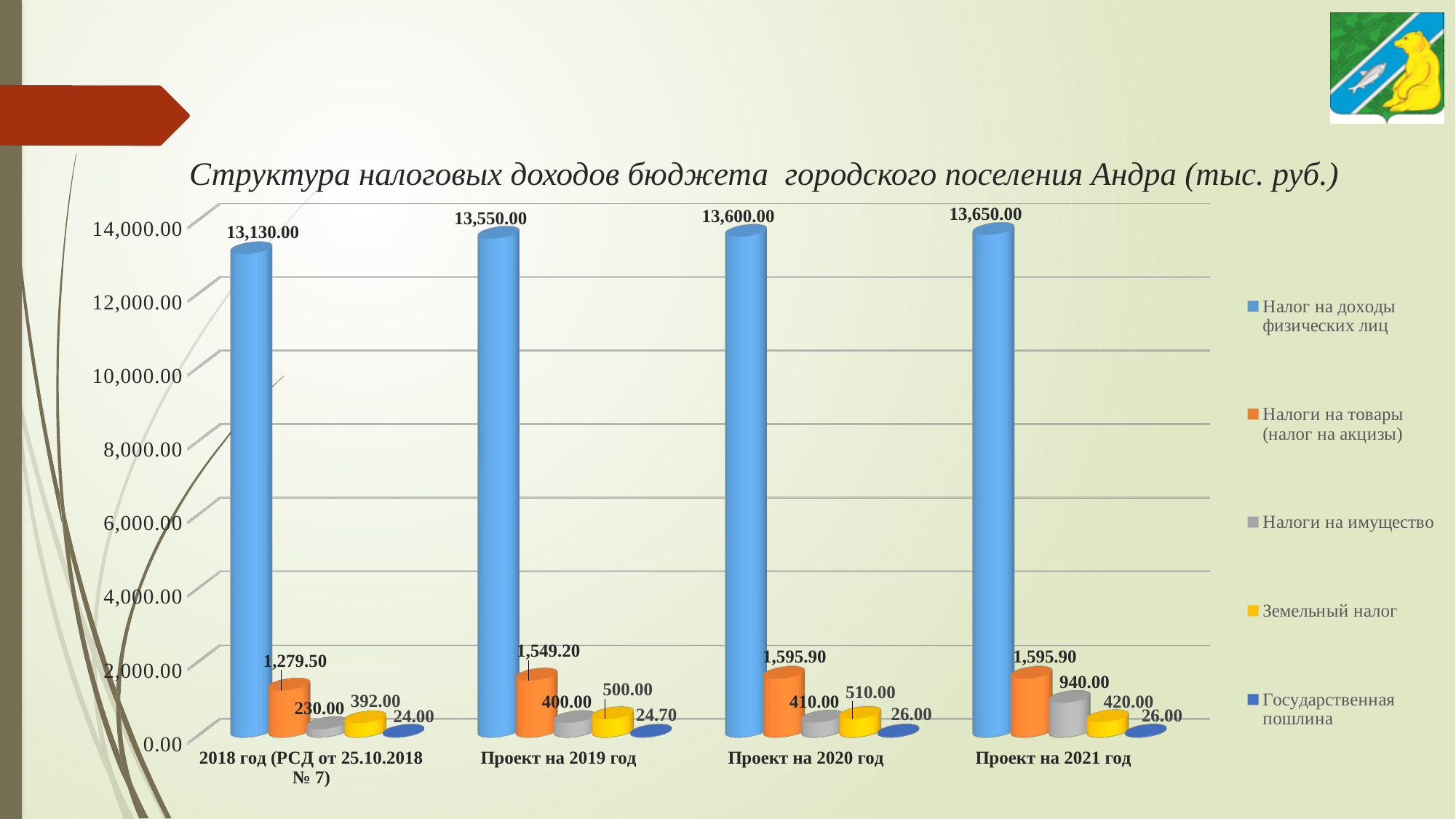
How many categories are shown on the x axis? 4 How many series does the legend list? 5 What is the difference between Налог на доходы физических лиц for Проект на 2021 год and for 2018 год (РСД от 25.10.2018 № 7)? 520.00 What is the value of Налоги на имущество for Проект на 2021 год? 940.00 What is the value of Государственная пошлина for Проект на 2019 год? 24.70 What is the value of Земельный налог for 2018 год (РСД от 25.10.2018 № 7)? 392.00 Does Налог на доходы физических лиц rise or fall from 2018 год to Проект на 2021 год? Rise Which is larger: Земельный налог for Проект на 2020 год or for Проект на 2021 год? Проект на 2020 год What kind of chart is shown on the slide? Bar chart In which category is Налог на доходы физических лиц the highest? Проект на 2021 год In which category is Налоги на имущество the lowest? 2018 год (РСД от 25.10.2018 № 7) What is the value of Налог на доходы физических лиц for Проект на 2019 год? 13,550.00